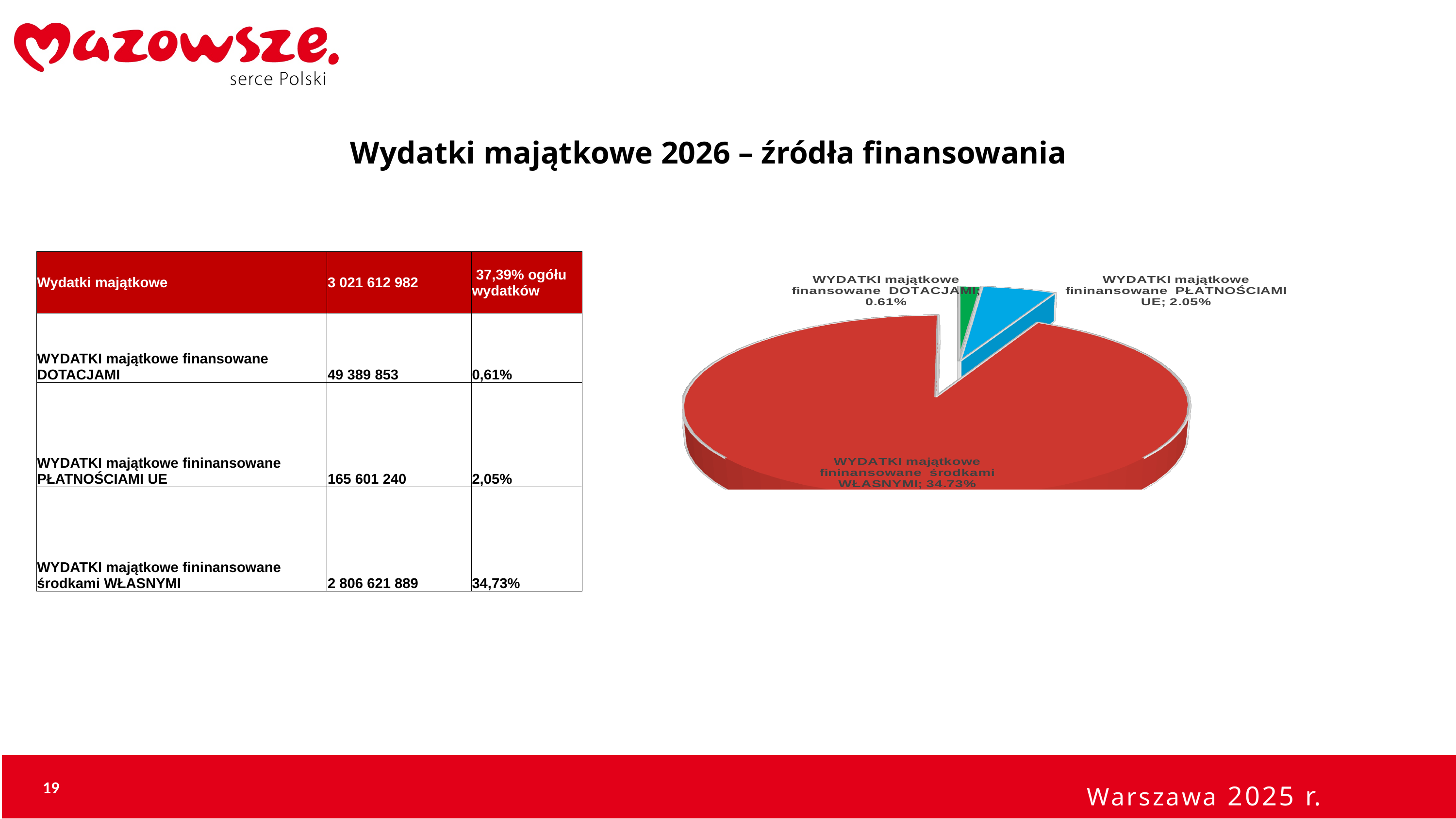
Which slice of the pie chart is the largest? WYDATKI majątkowe fininansowane środkami WŁASNYMI What percentage is shown on the pie chart for WYDATKI majątkowe fininansowane PŁATNOŚCIAMI UE? 2.05% What kind of chart is shown on the slide? pie chart Which slice of the pie chart is the smallest? WYDATKI majątkowe finansowane DOTACJAMI What percentage is shown on the pie chart for WYDATKI majątkowe finansowane DOTACJAMI? 0.61% What colour is the slice for WYDATKI majątkowe fininansowane środkami WŁASNYMI on the pie chart? red What is the difference in percentage points between the PŁATNOŚCIAMI UE slice and the DOTACJAMI slice on the pie chart? 1.44 What percentage is shown on the pie chart for WYDATKI majątkowe fininansowane środkami WŁASNYMI? 34.73% What colour is the slice for WYDATKI majątkowe finansowane DOTACJAMI on the pie chart? green On the pie chart, which is larger: the slice for PŁATNOŚCIAMI UE or the slice for DOTACJAMI? PŁATNOŚCIAMI UE What is the difference in percentage points between the środkami WŁASNYMI slice and the PŁATNOŚCIAMI UE slice on the pie chart? 32.68 How many slices does the pie chart have? 3